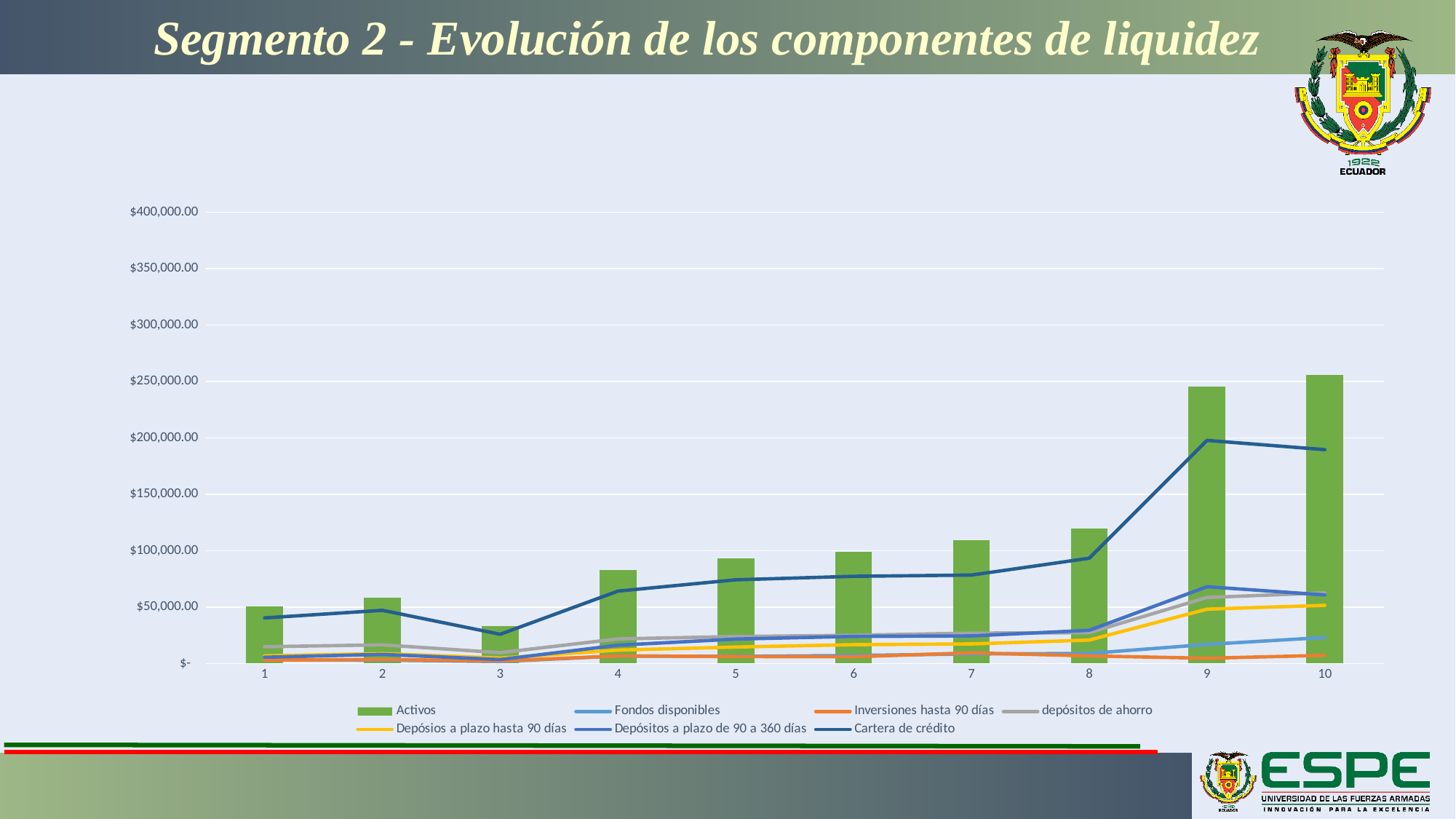
Which is larger, the Activos value at category 8 or at category 9? Category 9 Does the Activos series rise or fall from category 3 to category 10? Rise At which category is the Activos bar lowest? 3 What is the title of the slide containing the chart? Segmento 2 - Evolución de los componentes de liquidez What kind of chart is shown on the slide? A combined bar and line chart How many categories are shown along the x axis? 10 Is the Activos value at category 4 greater or less than $100,000.00? less Is the Activos value at category 9 greater or less than $200,000.00? greater How many series does the legend list? 7 Is the Cartera de crédito value at category 8 greater or less than $100,000.00? less Which series is plotted as bars? Activos At which category is the Activos bar highest? 10